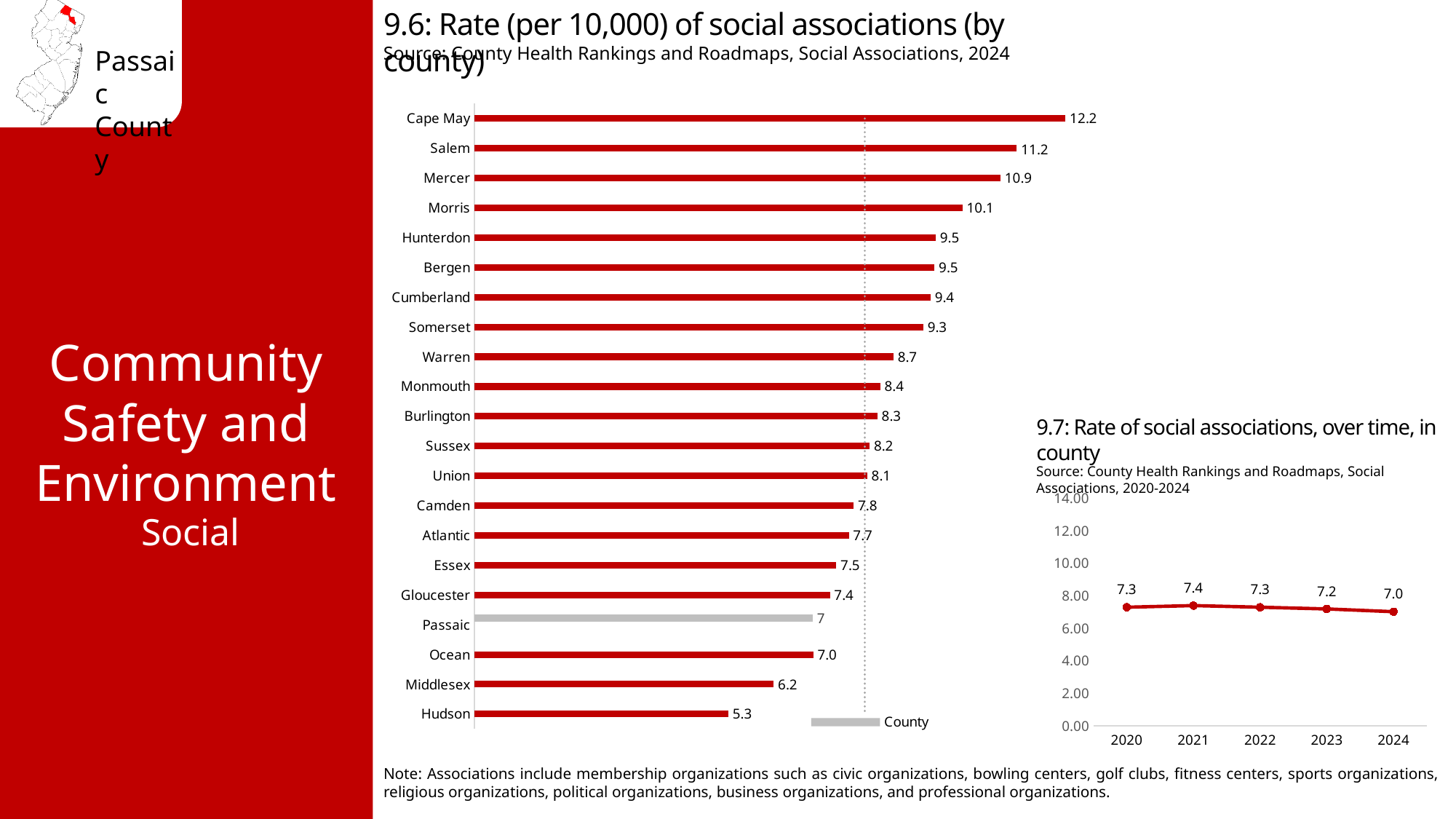
In chart 9.6, which county has the lowest rate of social associations? Hudson In chart 9.7, does the rate of social associations rise or fall between 2021 and 2024? Fall In chart 9.6, how many counties are shown? 21 In chart 9.7, what is the rate of social associations in 2021? 7.4 In chart 9.6, which county has the highest rate of social associations? Cape May In chart 9.7, how many years are plotted? 5 In chart 9.6, what is the rate of social associations for Passaic? 7 In chart 9.6, what is the difference between the rates for Salem and Middlesex? 5.0 In chart 9.7, what is the rate of social associations in 2024? 7.0 In chart 9.6, which county has a higher rate of social associations, Mercer or Morris? Mercer What type of chart is chart 9.6? Bar chart In chart 9.6, what is the rate of social associations for Cape May? 12.2